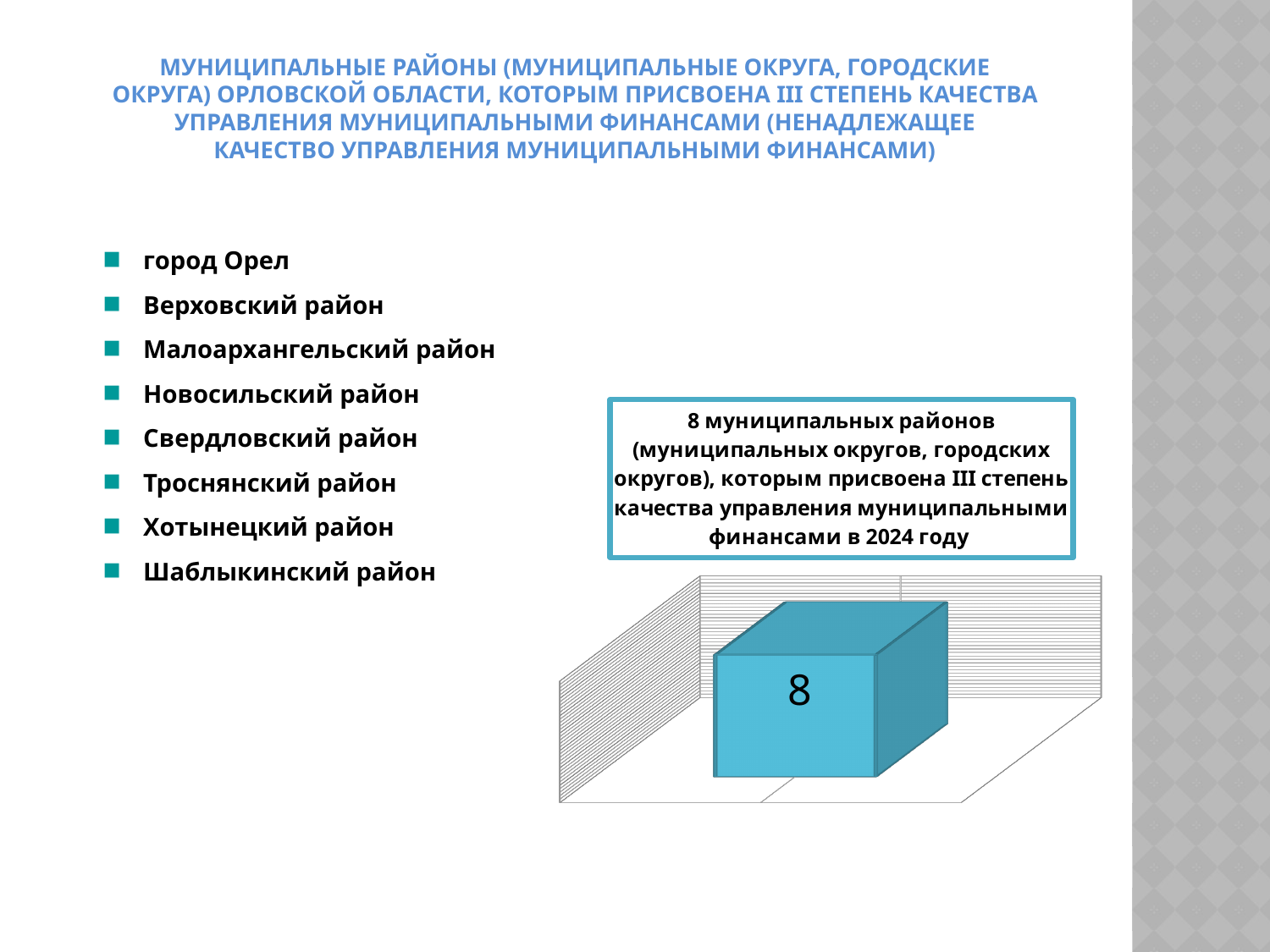
What year does the chart's title box refer to? 2024 According to the chart, how many municipal districts (municipal okrugs, urban okrugs) were assigned the III degree of quality of municipal finance management in 2024? 8 What value is printed on the single bar in the chart? 8 Is the value shown on the bar greater or less than 5? greater Is the value shown on the bar greater or less than 10? less What colour is the bar in the chart? blue How many bars does the chart show? 1 What kind of chart is shown on the slide? bar chart